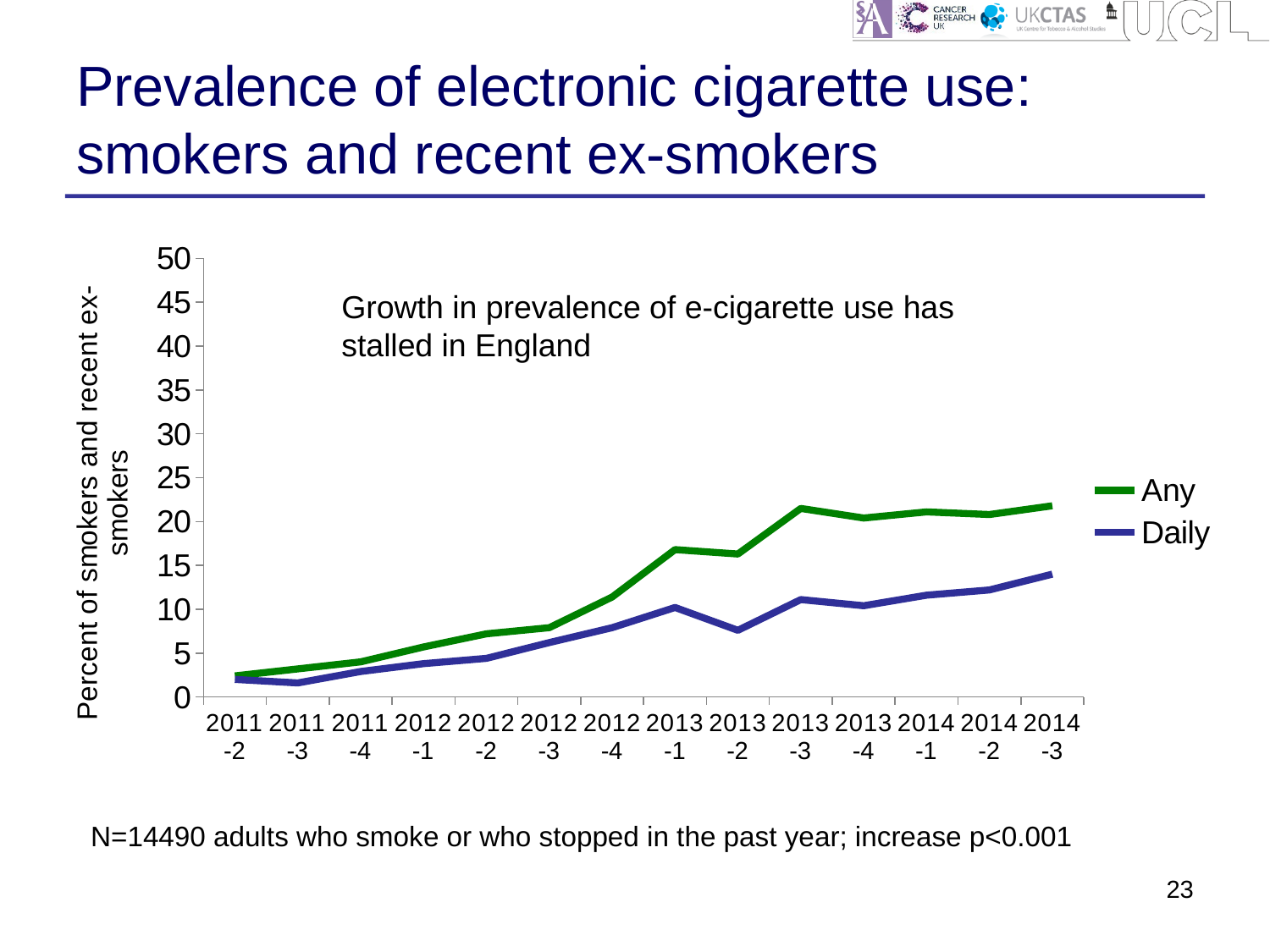
Which series is shown in green in the legend? Any What is the label on the y axis? Percent of smokers and recent ex-smokers Do the values for the Any series generally rise or fall from 2011-2 to 2014-3? rise How many time points are plotted along the x axis? 14 At which time point is the Daily series at its highest? 2014-3 What kind of chart is shown on the slide? line chart At 2013-1, which series has the larger value, Any or Daily? Any Is the value for Any at 2013-3 greater or less than 20? greater Is the value for Daily at 2013-2 greater or less than 10? less How many series does the legend list? 2 Is the value for Any at 2011-2 greater or less than 5? less